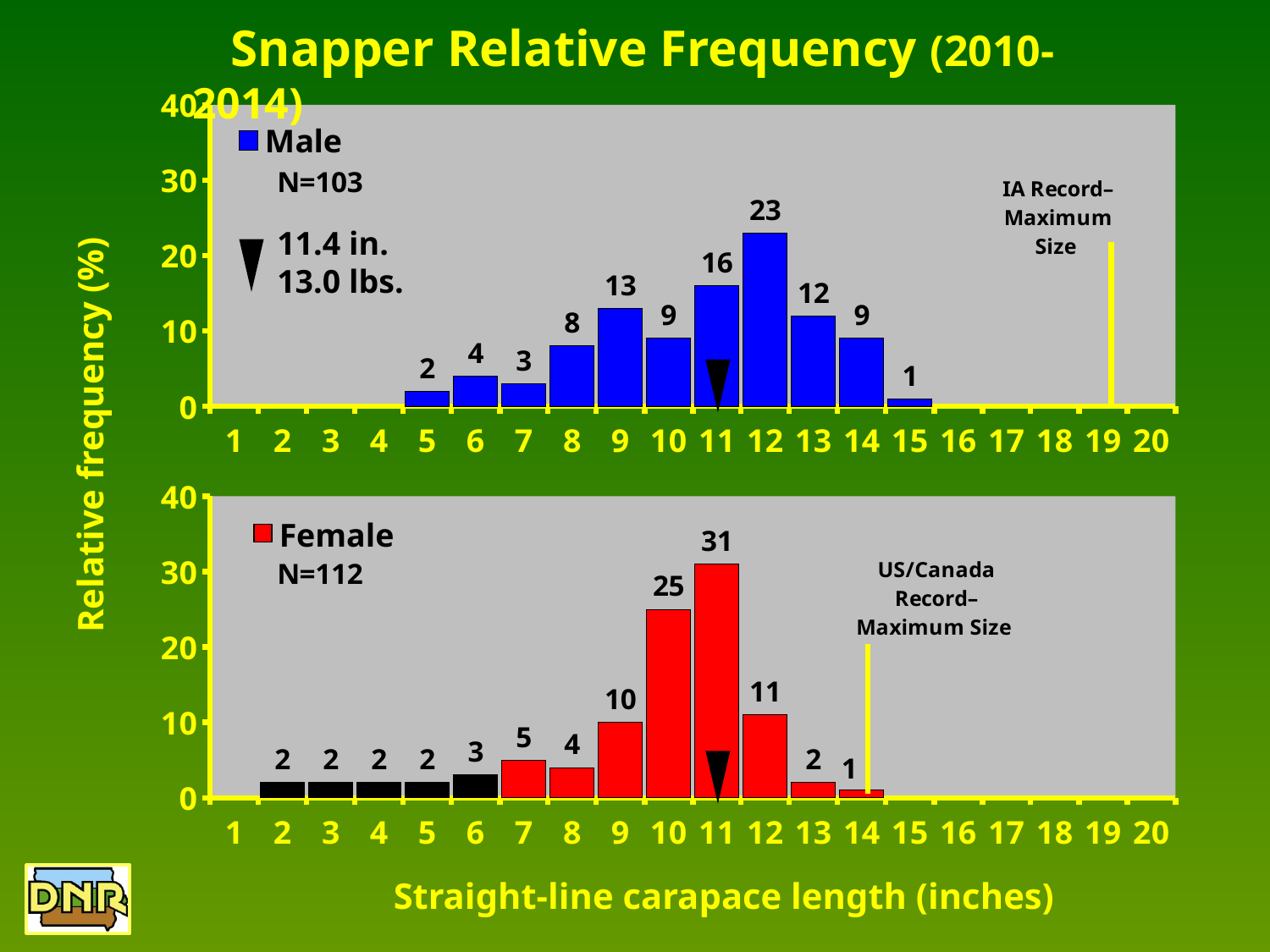
In the Male chart (top), what is the relative frequency for a carapace length of 12 inches? 23 What is the sample size (N) shown in the Female chart (bottom)? N=112 In the Female chart (bottom), is the relative frequency at 11 inches greater or less than 30? greater What kind of chart is the Male chart (top)? Bar chart In the Male chart (top), which is larger, the relative frequency at 9 inches or at 13 inches? 9 inches In the Male chart (top), which carapace length has the highest relative frequency? 12 In the Female chart (bottom), which carapace length has the highest relative frequency? 11 In the Female chart (bottom), how many carapace length categories have a bar plotted? 13 In the Female chart (bottom), what is the difference between the relative frequency at 11 inches and at 10 inches? 6 In the Male chart (top), which carapace length has the lowest relative frequency among the lengths with a bar? 15 In the Female chart (bottom), what is the relative frequency for a carapace length of 10 inches? 25 In the Male chart (top), what is the difference between the relative frequency at 12 inches and at 11 inches? 7